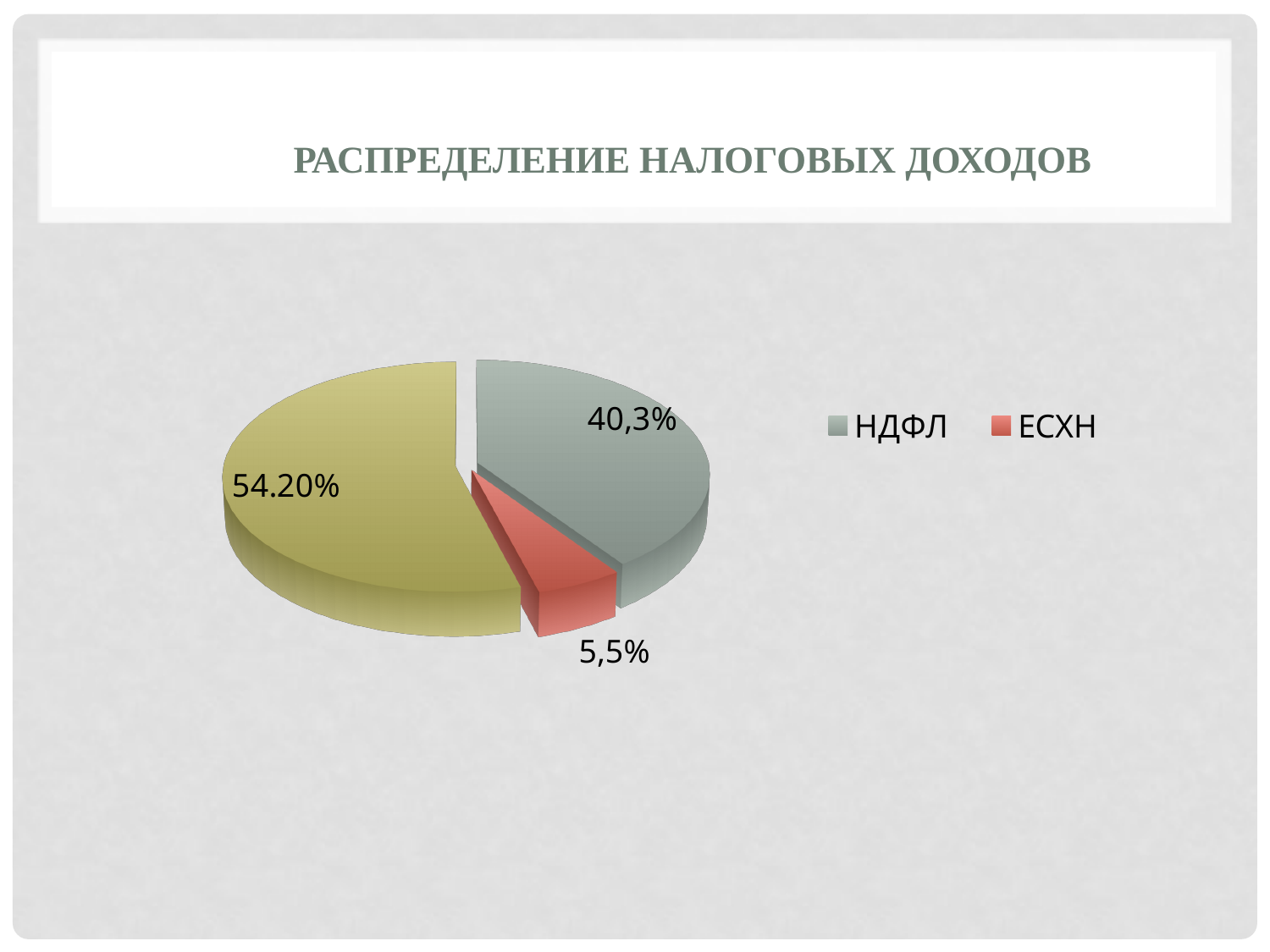
Which is larger, the share for НДФЛ or the share for ЕСХН? НДФЛ How many entries does the legend list? 2 By how many percentage points does the НДФЛ share exceed the ЕСХН share? 34,8% What percentage is shown for ЕСХН on the pie chart? 5,5% How many slices does the pie chart have? 3 What percentage is shown for НДФЛ on the pie chart? 40,3% What kind of chart is shown on the slide? Pie chart What colour is the ЕСХН slice in the pie chart? Red What is the largest value labelled on the pie chart? 54.20% What is the title of the slide? Распределение налоговых доходов Which of the two legend categories, НДФЛ or ЕСХН, has the smaller slice? ЕСХН